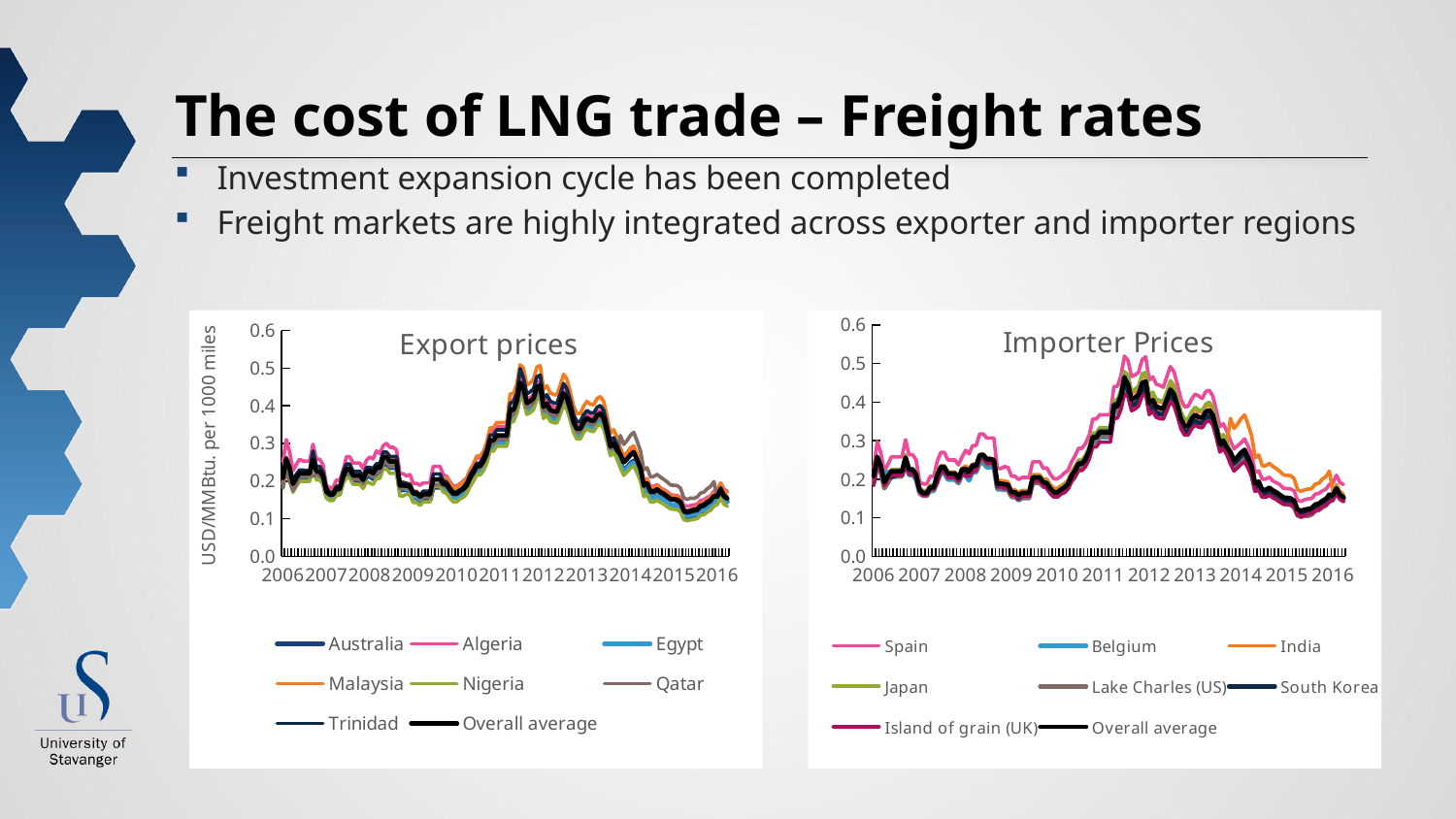
In the "Importer Prices" chart, which legend entry is drawn with the thick black line? Overall average In the "Export prices" chart, is the value of the Overall average line at the start of 2006 greater or less than 0.4? less In the "Importer Prices" chart, do the values of the Overall average line rise or fall between 2012 and 2015? fall How many series does the legend of the "Export prices" chart list? 8 How many year labels are shown on the x axis of the "Importer Prices" chart? 11 What kind of chart is the "Importer Prices" chart? line chart In the "Export prices" chart, is the peak value of the Overall average line around 2012 greater or less than 0.3? greater In the "Export prices" chart, do the values of the Overall average line rise or fall between 2010 and 2012? rise In the "Importer Prices" chart, is the value of the Overall average line at the end of 2015 greater or less than 0.3? less What kind of chart is the "Export prices" chart? line chart In the "Export prices" chart, what is the label on the vertical axis? USD/MMBtu. per 1000 miles How many series does the legend of the "Importer Prices" chart list? 8